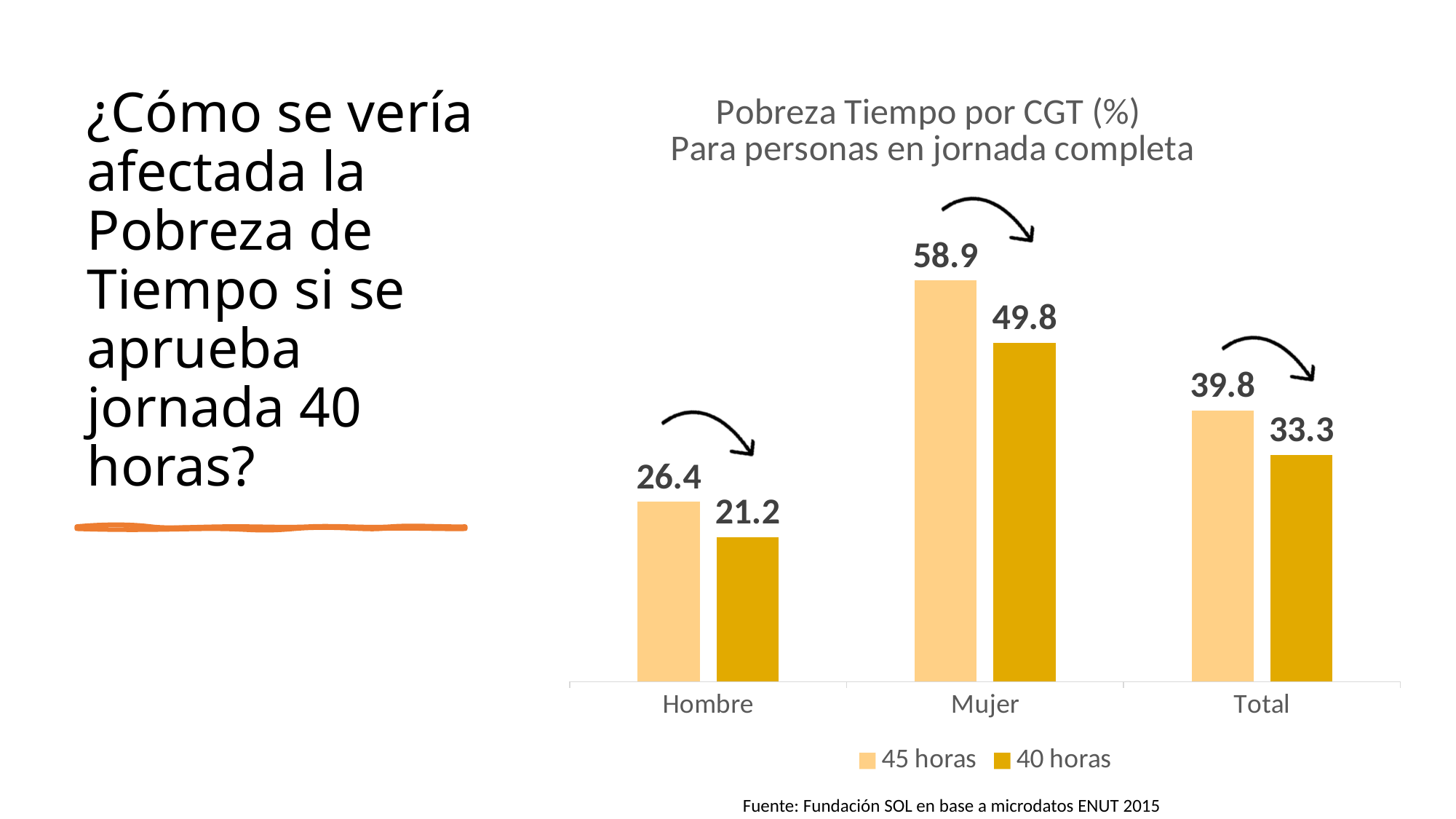
What is the difference between the 45 horas and 40 horas values for Mujer? 9.1 What kind of chart is shown on the slide? Bar chart How many series does the legend list? 2 What is the value for Mujer in the 45 horas series? 58.9 Which is larger: the 40 horas value for Mujer or the 45 horas value for Total? 40 horas value for Mujer Which category has the highest value in the 45 horas series? Mujer What is the difference between the 45 horas and 40 horas values for Total? 6.5 What is the value for Total in the 40 horas series? 33.3 What is the value for Hombre in the 40 horas series? 21.2 What are the two series named in the legend? 45 horas and 40 horas How many categories are shown on the x axis? 3 Which category has the lowest value in the 40 horas series? Hombre